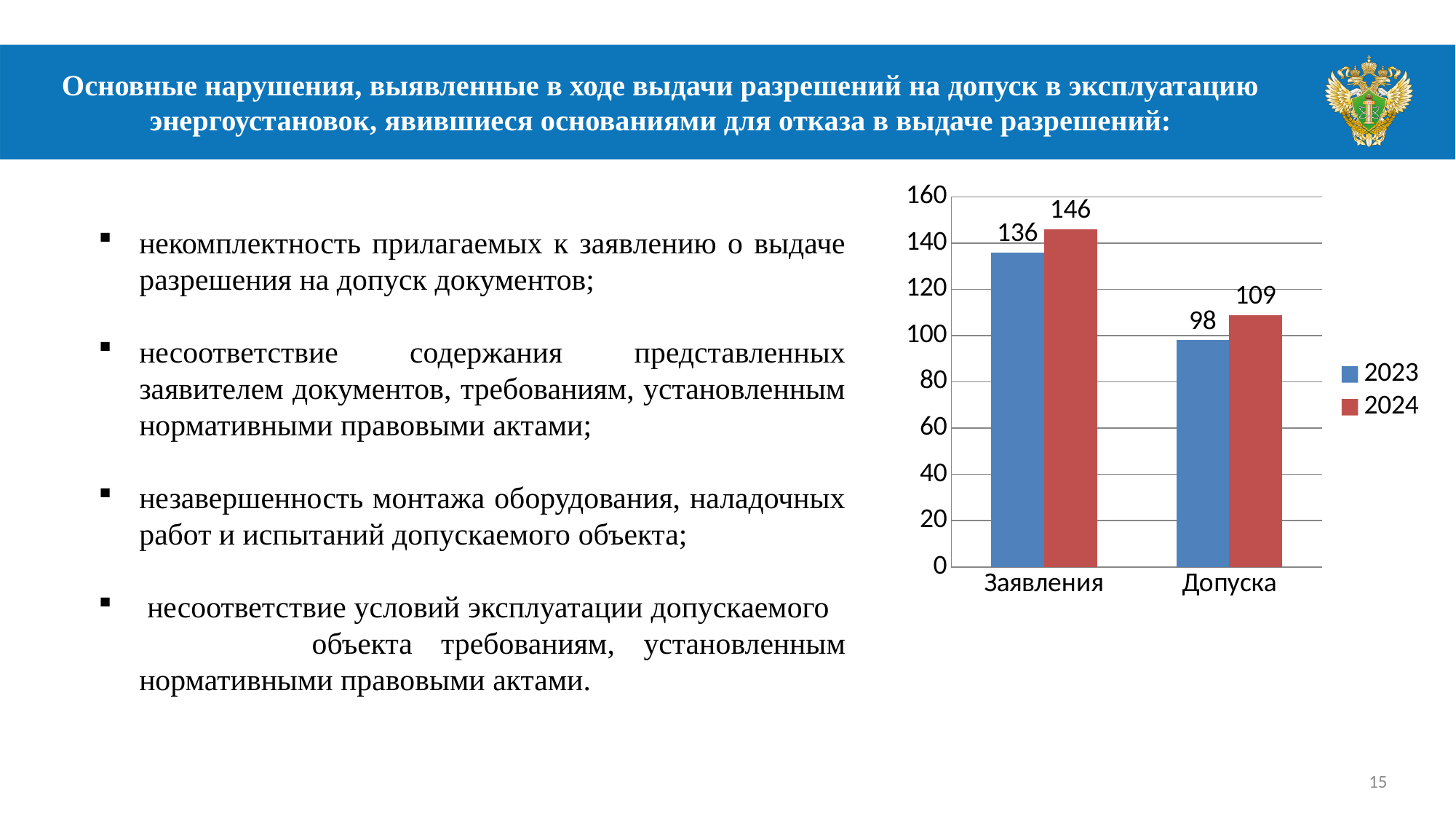
How many categories are shown on the x axis? 2 Which category has the highest value in the 2024 series? Заявления What kind of chart is shown on the slide? Bar chart What is the difference between the 2024 and 2023 values for Допуска? 11 Which is larger: the 2023 value for Заявления or the 2024 value for Допуска? 2023 value for Заявления What is the value for Допуска in 2023? 98 How many series does the legend list? 2 Which category has the lowest value in the 2023 series? Допуска What is the value for Заявления in 2024? 146 What is the value for Допуска in 2024? 109 What is the value for Заявления in 2023? 136 What is the difference between the 2024 and 2023 values for Заявления? 10